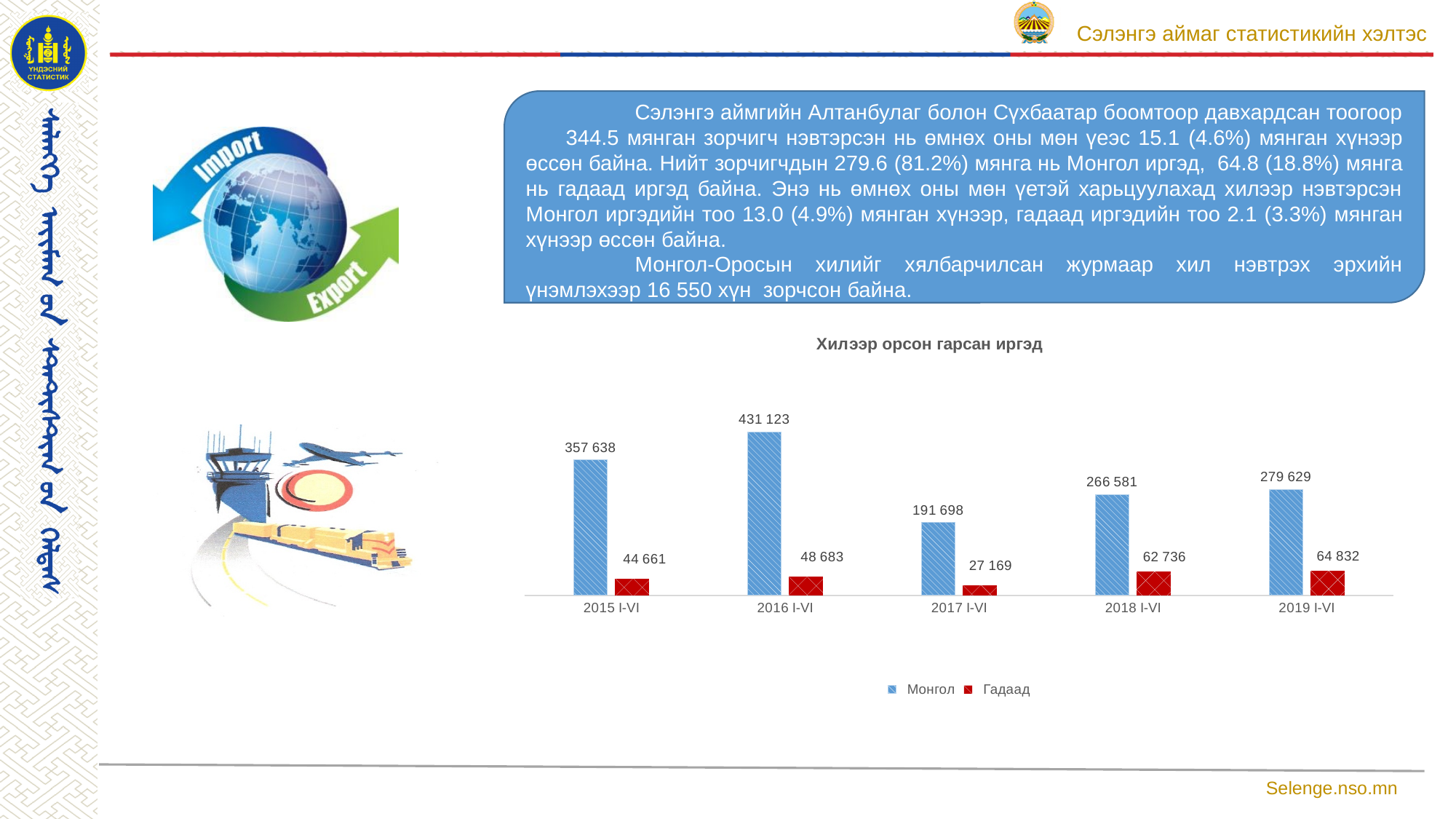
What is the value for Монгол in 2019 I-VI? 279 629 How many series does the legend list? 2 Which period has the lowest value for Гадаад? 2017 I-VI What kind of chart is shown? Bar chart What is the value for Монгол in 2016 I-VI? 431 123 How many periods are shown on the x axis? 5 What is the title of the chart? Хилээр орсон гарсан иргэд What is the value for Гадаад in 2017 I-VI? 27 169 What is the total of the Монгол and Гадаад values for 2019 I-VI? 344 461 Which period has the highest value for Монгол? 2016 I-VI What is the difference between the Монгол values for 2016 I-VI and 2017 I-VI? 239 425 Which is larger: the Гадаад value for 2018 I-VI or for 2019 I-VI? 2019 I-VI